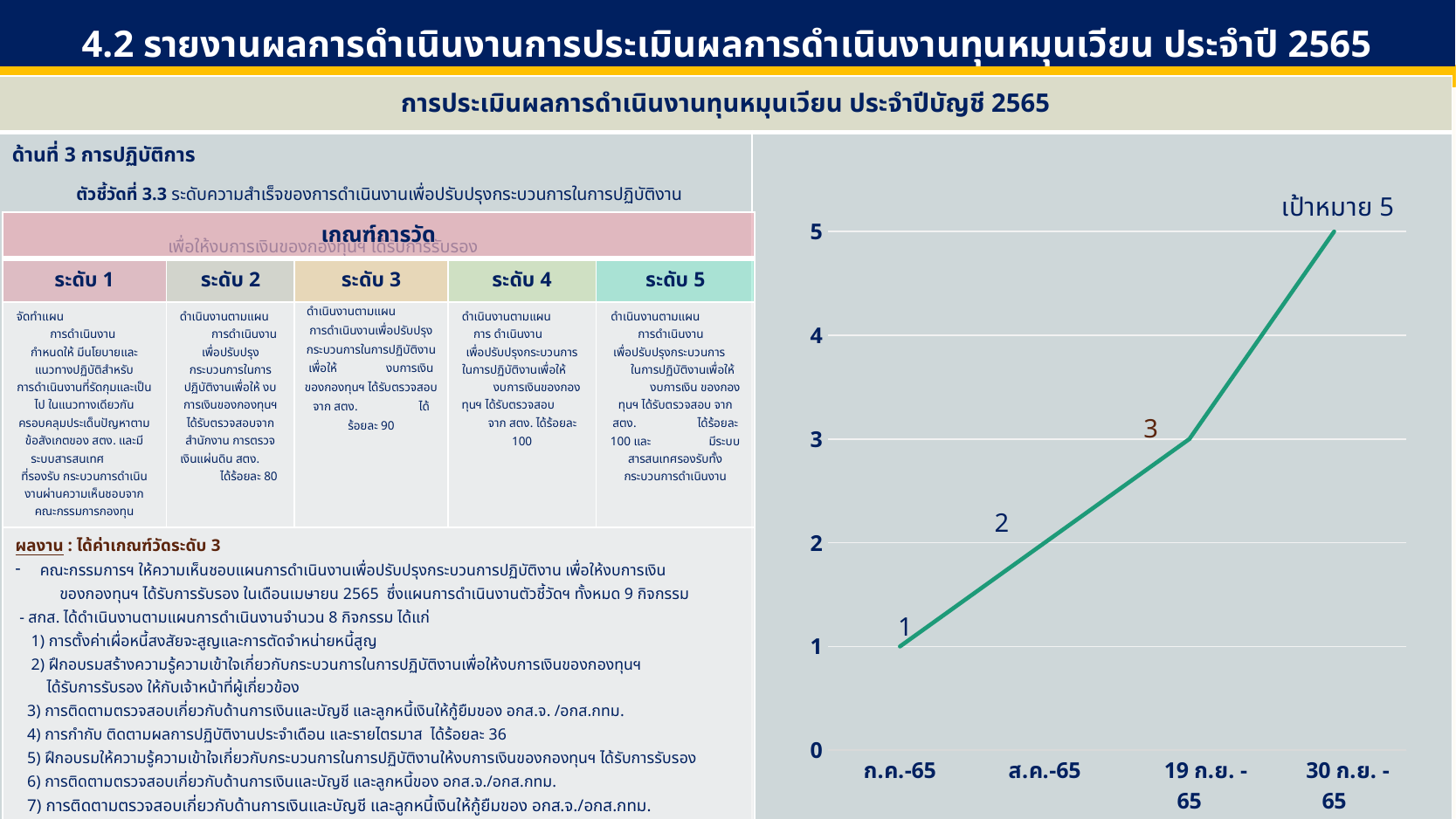
What is the value plotted for ก.ค.-65 on the line chart? 1 What is the value plotted for ส.ค.-65 on the line chart? 2 Which is larger on the line chart, the value for ส.ค.-65 or the value for 19 ก.ย.-65? 19 ก.ย. - 65 What is the difference between the values for 30 ก.ย.-65 and 19 ก.ย.-65 on the line chart? 2 How many data points are plotted on the line chart? 4 What kind of chart is shown on the right side of the slide? line chart Do the values on the line chart rise or fall from ก.ค.-65 to 30 ก.ย.-65? rise What is the value plotted for 19 ก.ย.-65 on the line chart? 3 What label is written next to the final point of the line chart? เป้าหมาย 5 Which category has the lowest value on the line chart? ก.ค.-65 Which category has the highest value on the line chart? 30 ก.ย. - 65 What is the value plotted for 30 ก.ย.-65 on the line chart? 5